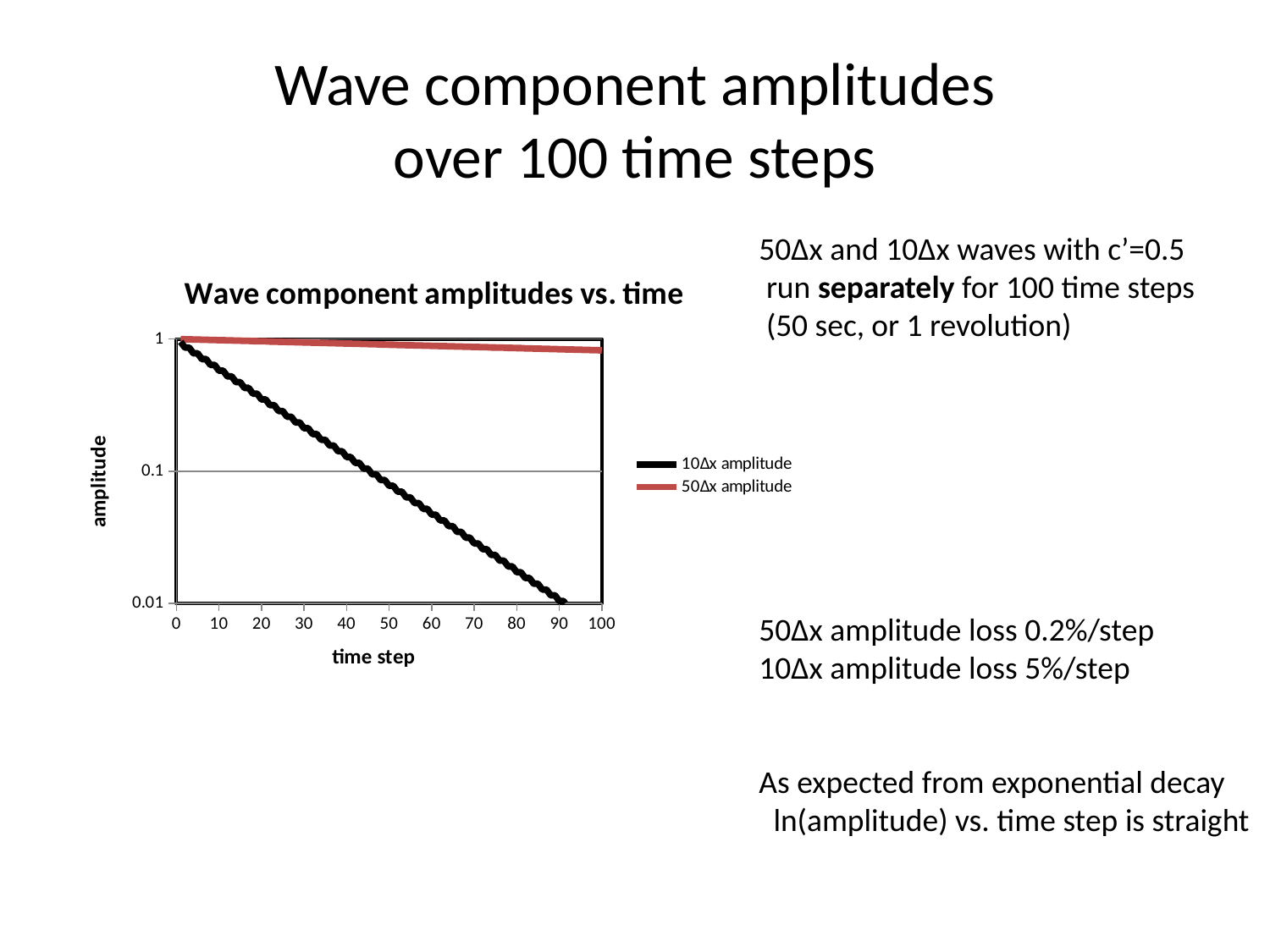
Does the 50Δx amplitude rise or fall as the time step increases? fall Which series is drawn in black? 10Δx amplitude Is the 50Δx amplitude at time step 100 greater or less than 0.1? greater What is the title of the chart? Wave component amplitudes vs. time How many series does the legend list? 2 At time step 50, which series has the larger amplitude, 10Δx or 50Δx? 50Δx amplitude Which series falls more steeply over the 100 time steps? 10Δx amplitude Is the 10Δx amplitude at time step 20 greater or less than 0.1? greater What is the label of the x axis? time step What kind of chart is shown on the slide? line chart Does the 10Δx amplitude rise or fall as the time step increases? fall Is the 10Δx amplitude at time step 80 greater or less than 0.1? less